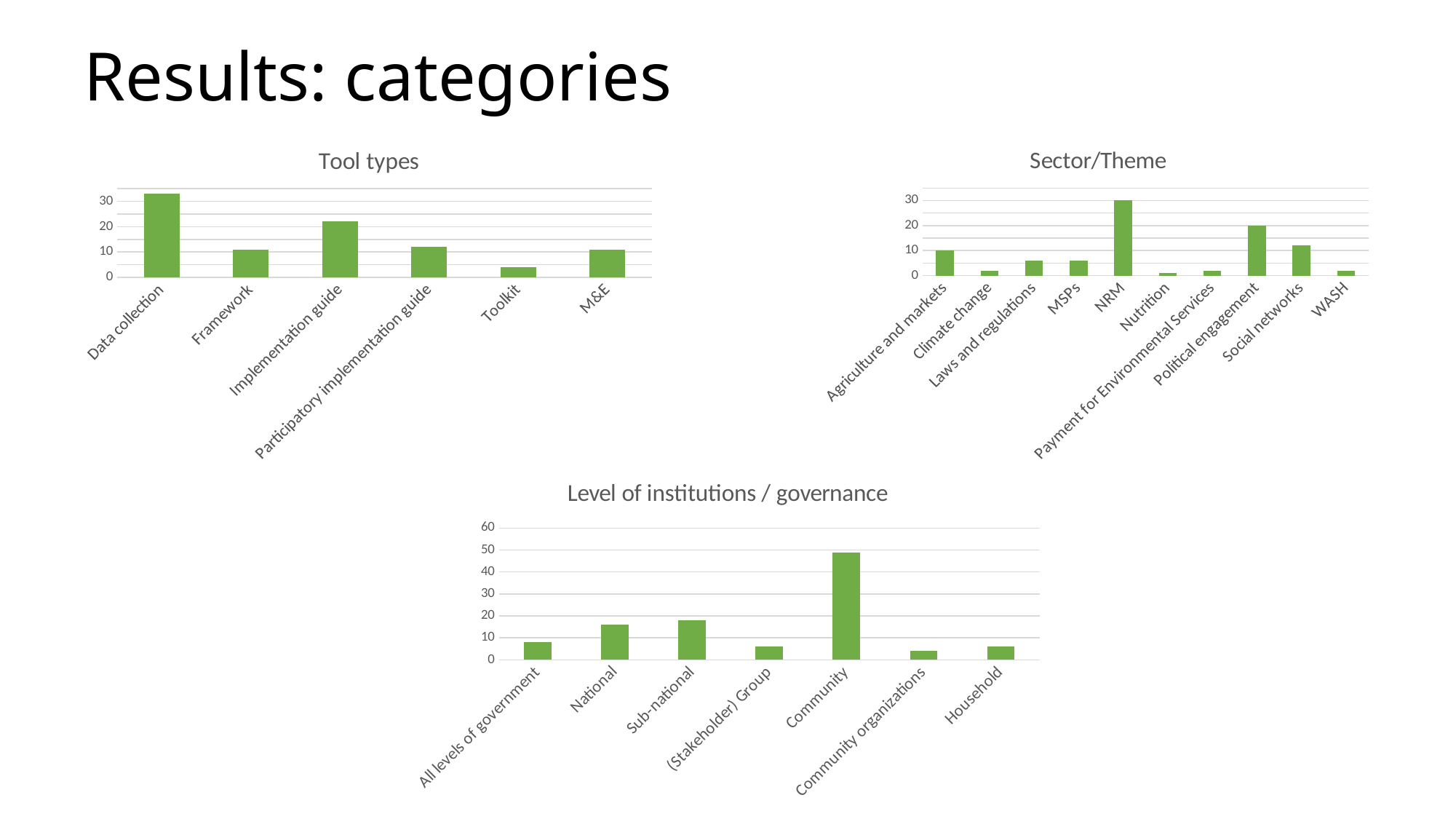
In the "Level of institutions / governance" chart, which category has the highest value? Community In the "Sector/Theme" chart, what is the value for Political engagement? 20 In the "Tool types" chart, is the value for Data collection greater or less than 30? greater In the "Level of institutions / governance" chart, which is larger, National or Community organizations? National How many categories are shown in the "Sector/Theme" chart? 10 In the "Tool types" chart, which category has the highest value? Data collection In the "Level of institutions / governance" chart, is the value for Community greater or less than 40? greater What kind of chart is the "Tool types" chart? bar chart In the "Sector/Theme" chart, which category has the highest value? NRM In the "Sector/Theme" chart, what is the value for NRM? 30 In the "Tool types" chart, which category has the lowest value? Toolkit How many categories are shown in the "Tool types" chart? 6